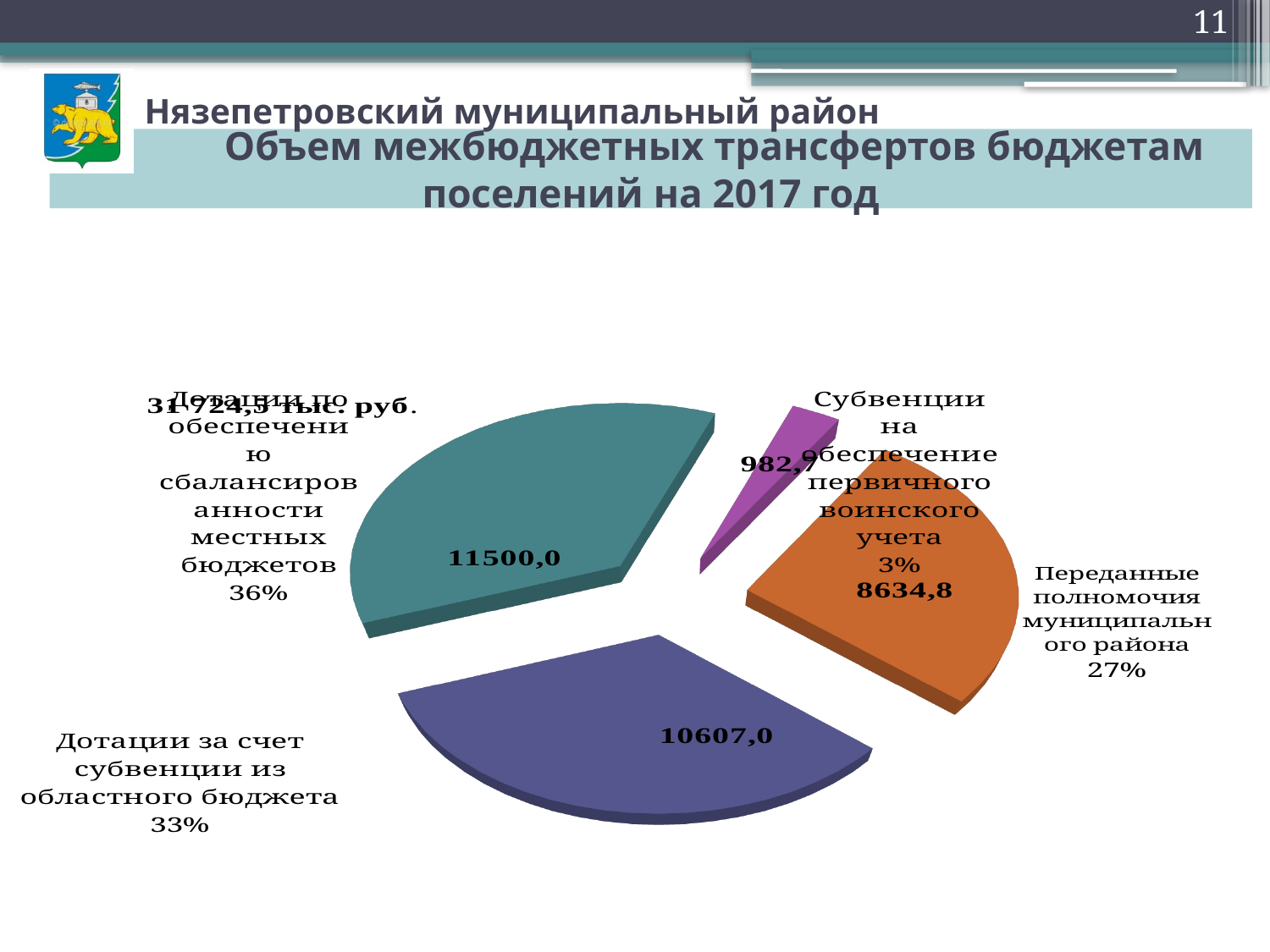
What is the value for "Переданные полномочия муниципального района"? 8634,8 Which is larger: the value for "Переданные полномочия муниципального района" or the value for "Субвенции на обеспечение первичного воинского учета"? Переданные полномочия муниципального района What is the difference between the values for "Дотации по обеспечению сбалансированности местных бюджетов" and "Дотации за счет субвенции из областного бюджета"? 893,0 Which category has the smallest slice of the pie? Субвенции на обеспечение первичного воинского учета What is the value for "Дотации по обеспечению сбалансированности местных бюджетов"? 11500,0 What is the value for "Субвенции на обеспечение первичного воинского учета"? 982,7 Which category has the largest slice of the pie? Дотации по обеспечению сбалансированности местных бюджетов What kind of chart is shown on the slide? pie chart What share of the pie does "Переданные полномочия муниципального района" represent? 27% What is the value for "Дотации за счет субвенции из областного бюджета"? 10607,0 How many slices does the pie chart have? 4 What share of the pie does "Дотации за счет субвенции из областного бюджета" represent? 33%